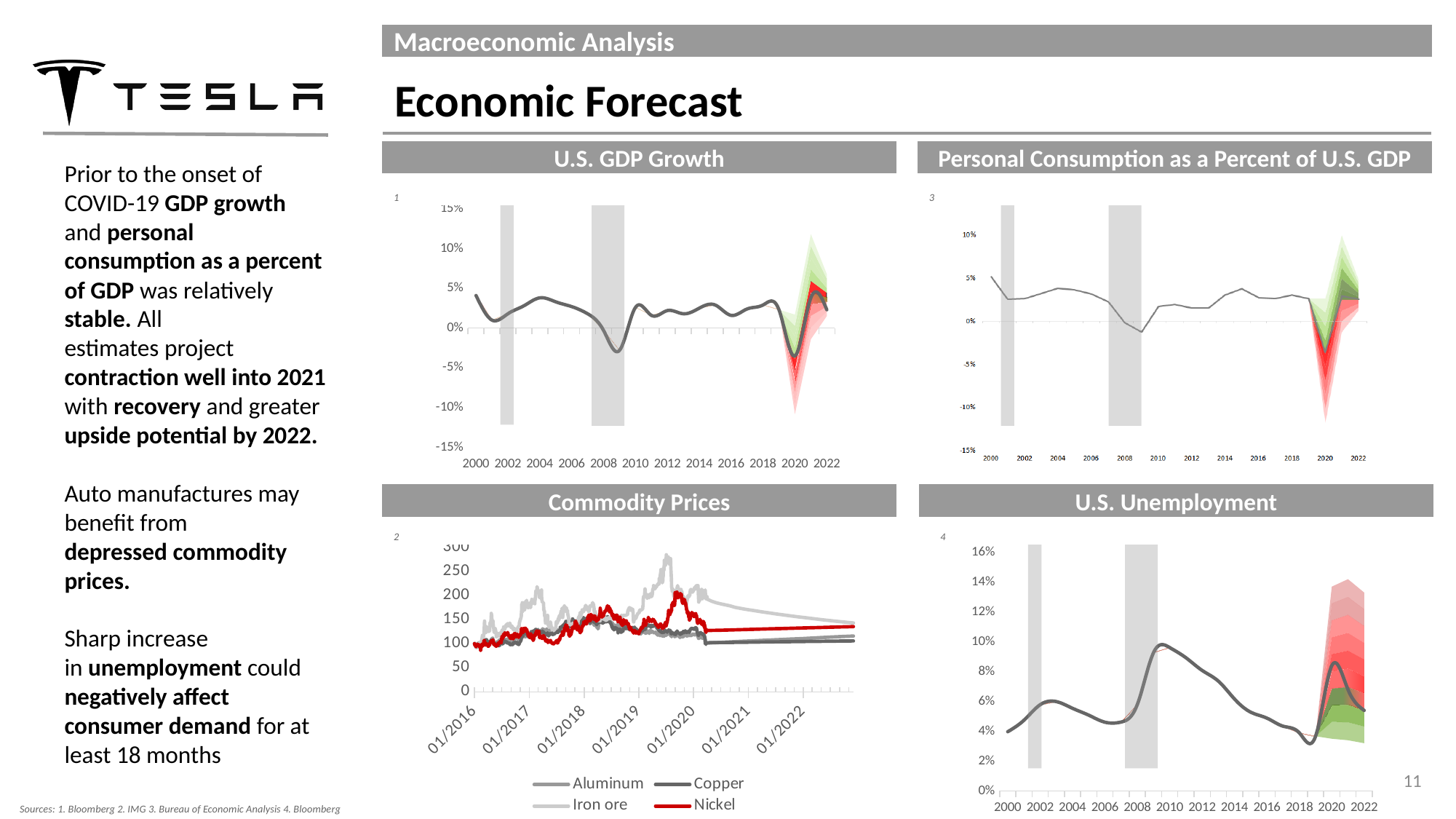
In the Personal Consumption as a Percent of U.S. GDP chart, is the value for 2009 greater or less than 5%? less What kind of chart is the Commodity Prices chart? line chart What kind of chart is the U.S. GDP Growth chart? line chart In the Commodity Prices chart, is the peak value of Iron ore around 2019 greater or less than 250? greater In the U.S. Unemployment chart, is the peak value around 2010 greater or less than 8%? greater What are the legend entries of the Commodity Prices chart? Aluminum, Copper, Iron ore, Nickel In the Commodity Prices chart, which series is drawn in red? Nickel In the U.S. Unemployment chart, do values rise or fall from 2010 to 2019? fall In the U.S. GDP Growth chart, do values rise or fall from 2019 to 2020? fall How many series does the legend of the Commodity Prices chart list? 4